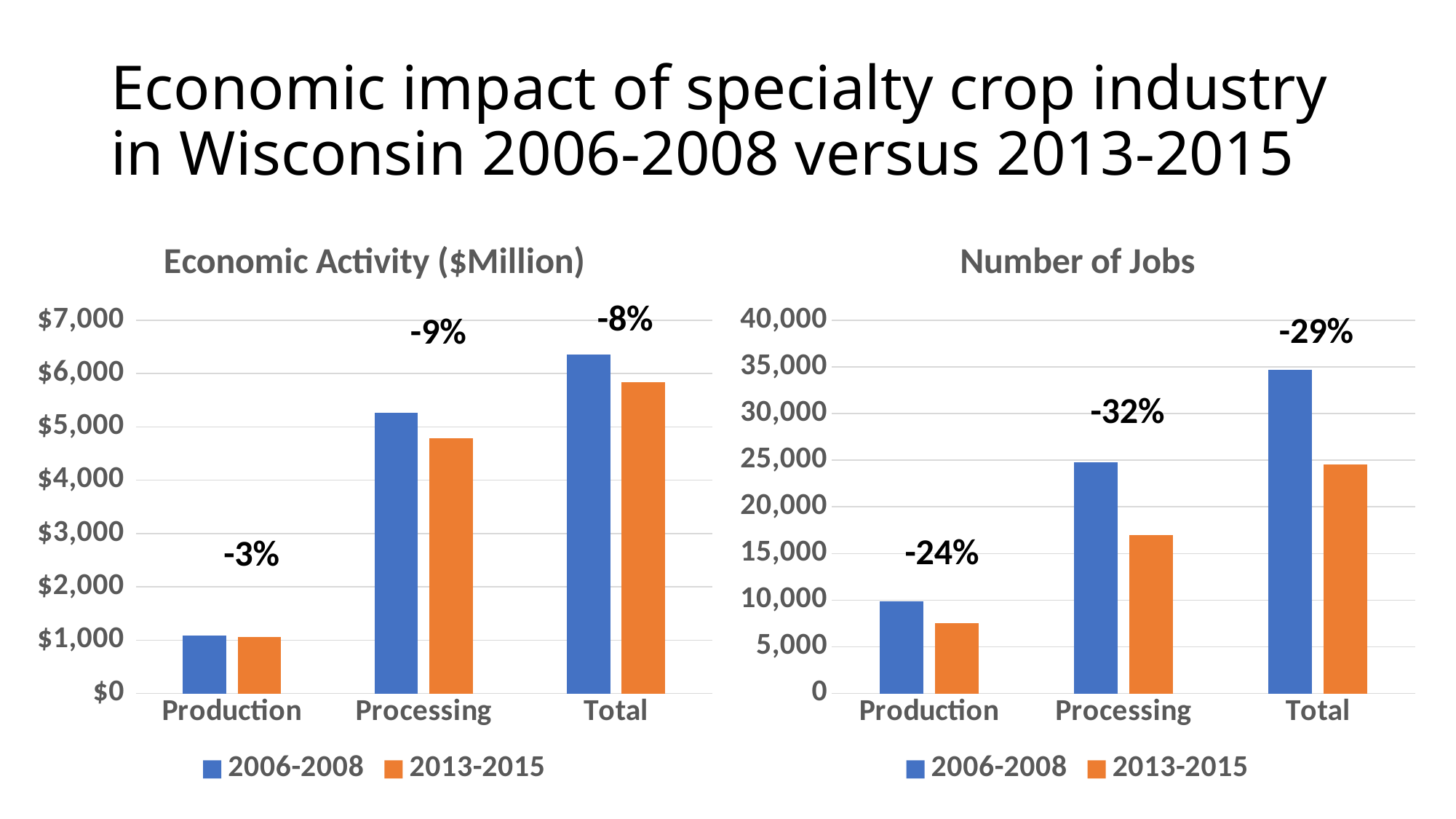
In the Economic Activity ($Million) chart, is the 2013-2015 value for Processing greater or less than $5,000? less In the Economic Activity ($Million) chart, is the 2006-2008 value for Total greater or less than $6,000? greater In the Number of Jobs chart, which category shows the largest percentage decline? Processing In the Number of Jobs chart, what percentage change is labelled above the Production bars? -24% How many series does the legend of the Number of Jobs chart list? 2 In the Economic Activity ($Million) chart, what percentage change is labelled above the Processing bars? -9% In the Number of Jobs chart, is the 2013-2015 value for Processing greater or less than 15,000? greater What kind of chart is the Economic Activity ($Million) chart? Bar chart In the Number of Jobs chart, which is larger for Total: the 2006-2008 bar or the 2013-2015 bar? 2006-2008 In the Economic Activity ($Million) chart, which category shows the smallest percentage decline? Production In the Number of Jobs chart, what percentage change is labelled above the Processing bars? -32% In the Economic Activity ($Million) chart, what percentage change is labelled above the Total bars? -8%